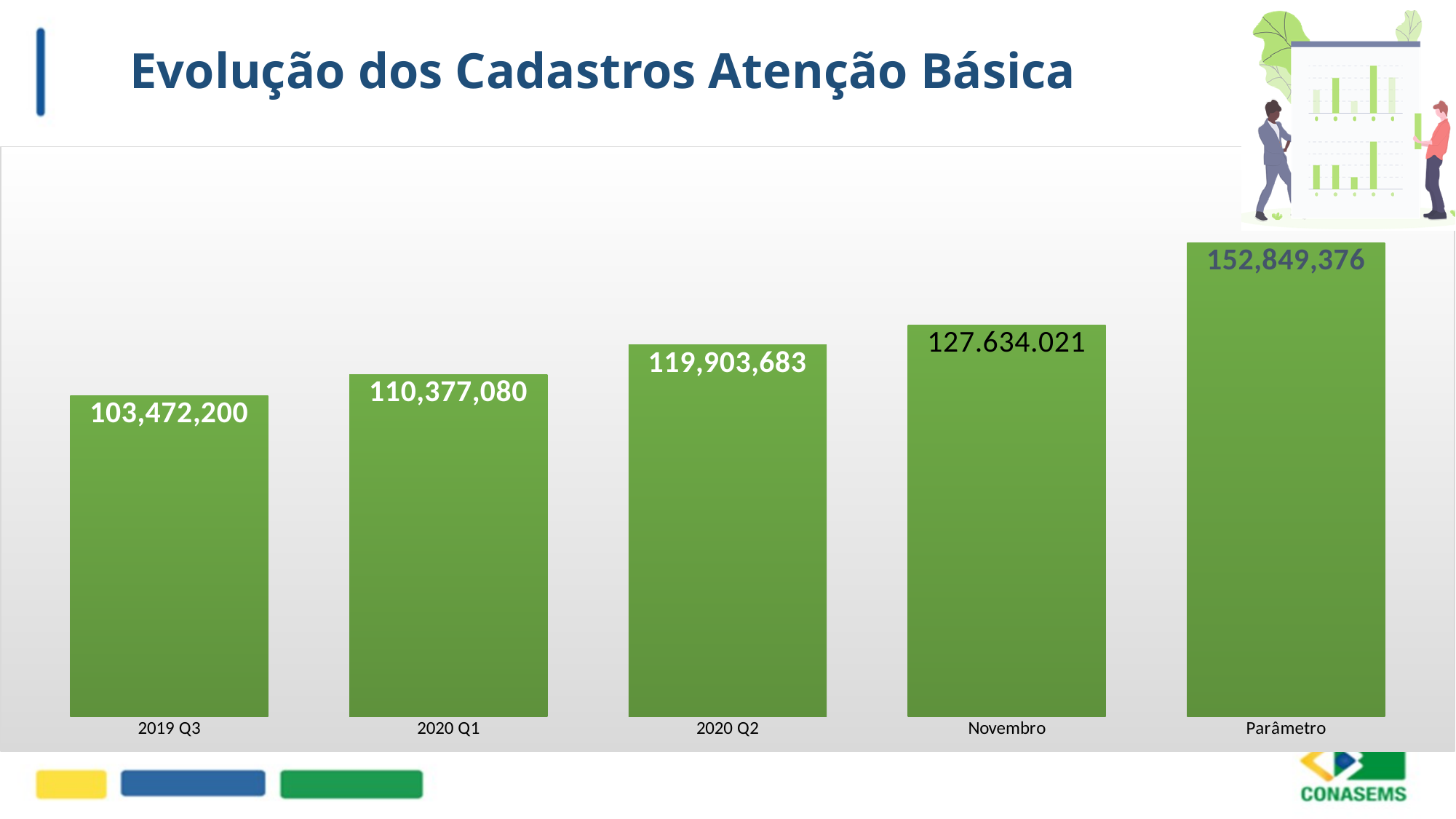
How many bars are shown in the chart? 5 What is the value for 2020 Q1? 110,377,080 Which category has the lowest value? 2019 Q3 What is the value for Novembro? 127.634.021 What is the difference between the values for 2020 Q1 and 2019 Q3? 6,904,880 What is the value for 2019 Q3? 103,472,200 Which is larger, the value for 2020 Q2 or the value for Novembro? Novembro Which category has the highest value? Parâmetro What is the value for 2020 Q2? 119,903,683 What is the difference between the values for Parâmetro and 2019 Q3? 49,377,176 What is the value for Parâmetro? 152,849,376 Do the values rise or fall from left to right along the x axis? rise